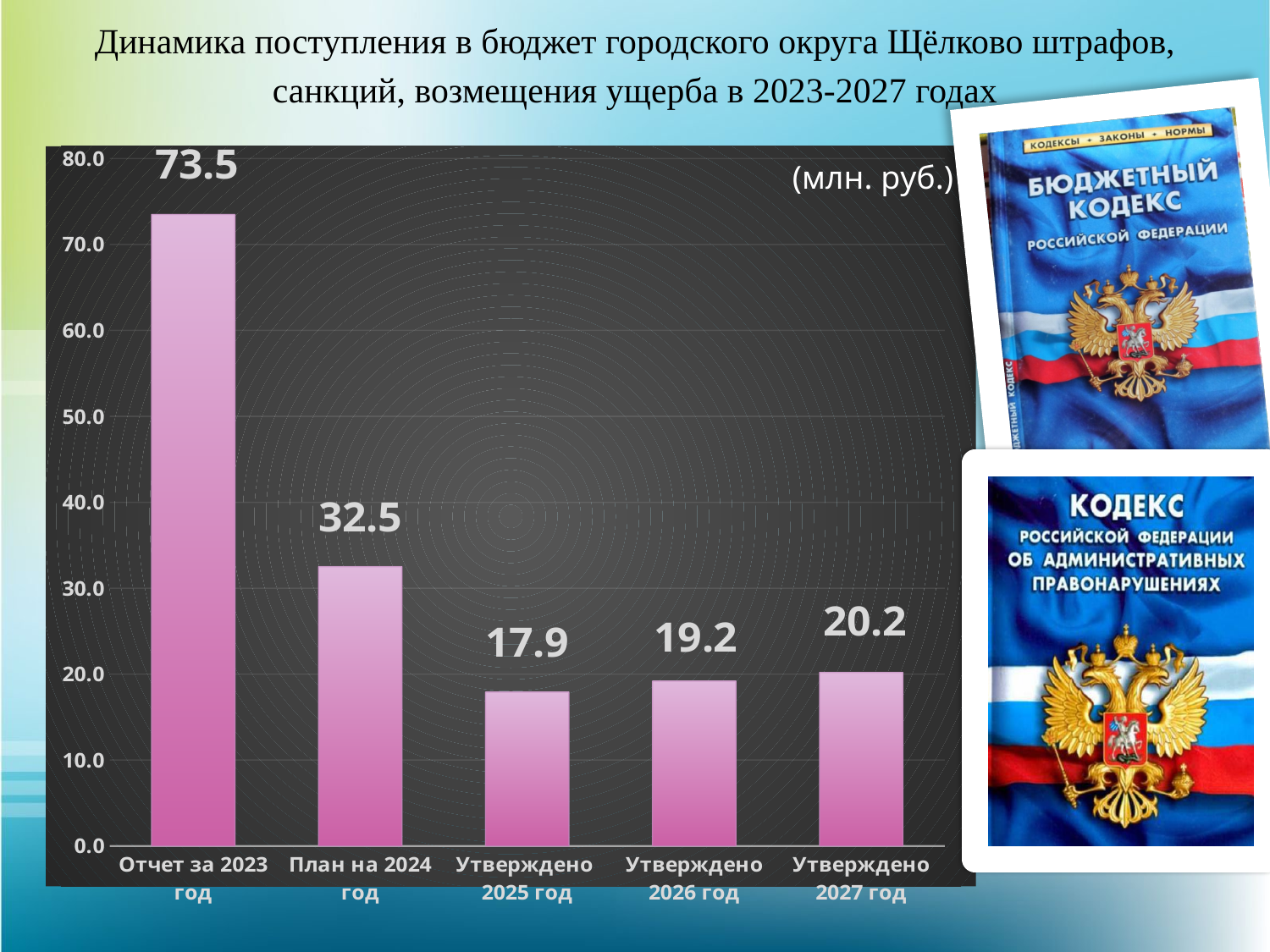
Do the values rise or fall from "Утверждено 2025 год" to "Утверждено 2027 год"? Rise What unit is indicated for the values on the chart? млн. руб. What kind of chart is shown on the slide? Bar chart What is the value for "Утверждено 2025 год"? 17.9 Which category has the highest value? Отчет за 2023 год What is the value for "План на 2024 год"? 32.5 How many categories are shown on the chart? 5 What is the difference between the values for "Отчет за 2023 год" and "План на 2024 год"? 41.0 Which is larger: the value for "Утверждено 2026 год" or "Утверждено 2027 год"? Утверждено 2027 год What is the value for "Отчет за 2023 год"? 73.5 Which category has the lowest value? Утверждено 2025 год What is the value for "Утверждено 2027 год"? 20.2